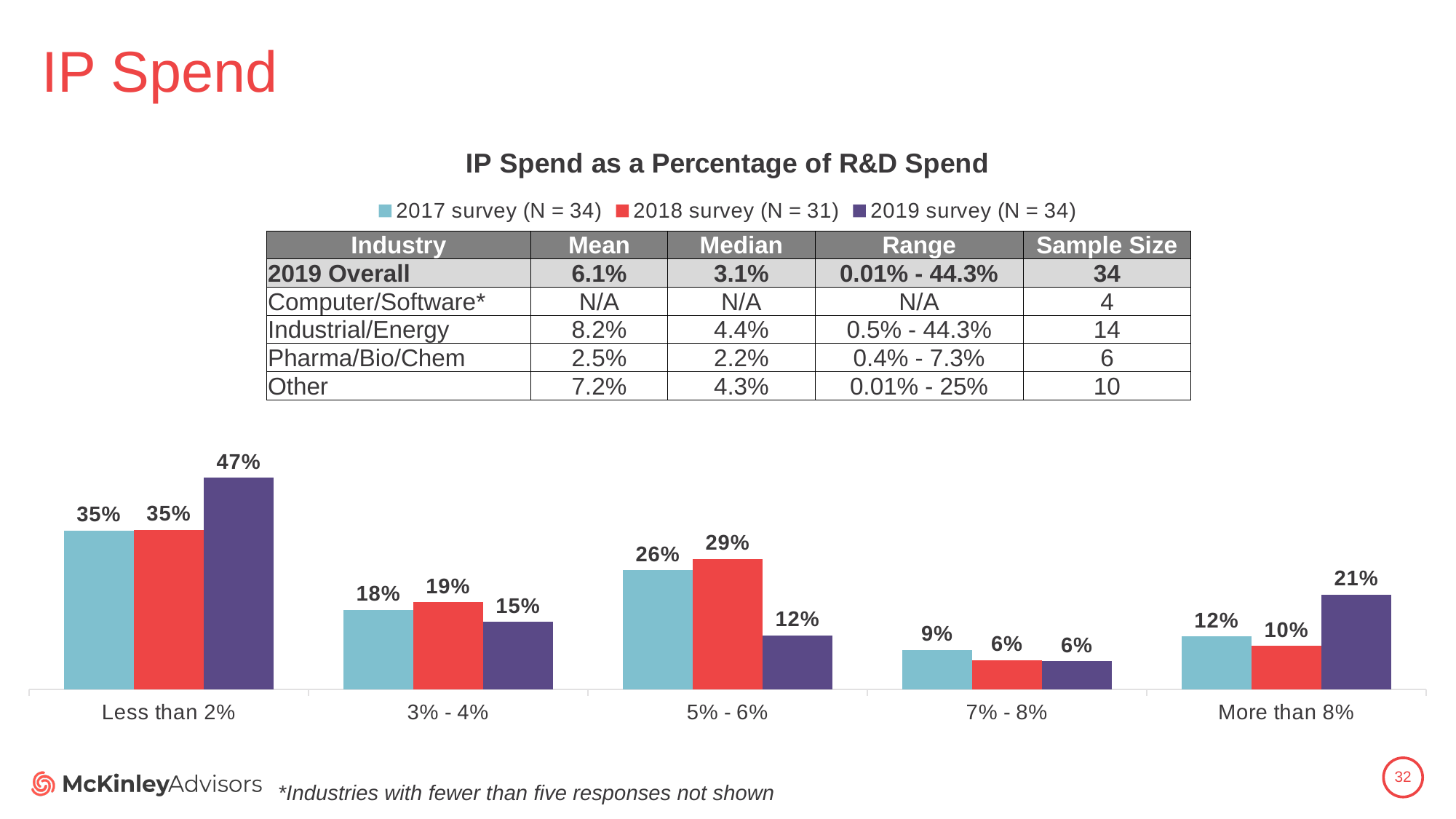
What is the value for the 2018 survey in the 'More than 8%' category? 10% What is the sample size (N) for the 2018 survey according to the legend? 31 What is the value for the 2019 survey in the 'Less than 2%' category? 47% What is the difference between the 2019 survey and 2017 survey values in the 'Less than 2%' category? 12% What kind of chart is shown on the slide? Bar chart Which category has the highest value for the 2019 survey? Less than 2% What is the value for the 2017 survey in the '5% - 6%' category? 26% Which category has the lowest value for the 2018 survey? 7% - 8% In the '5% - 6%' category, which is larger: the 2018 survey value or the 2019 survey value? 2018 survey How many series does the chart legend list? 3 How many categories are shown on the x axis of the chart? 5 What is the title of the chart? IP Spend as a Percentage of R&D Spend